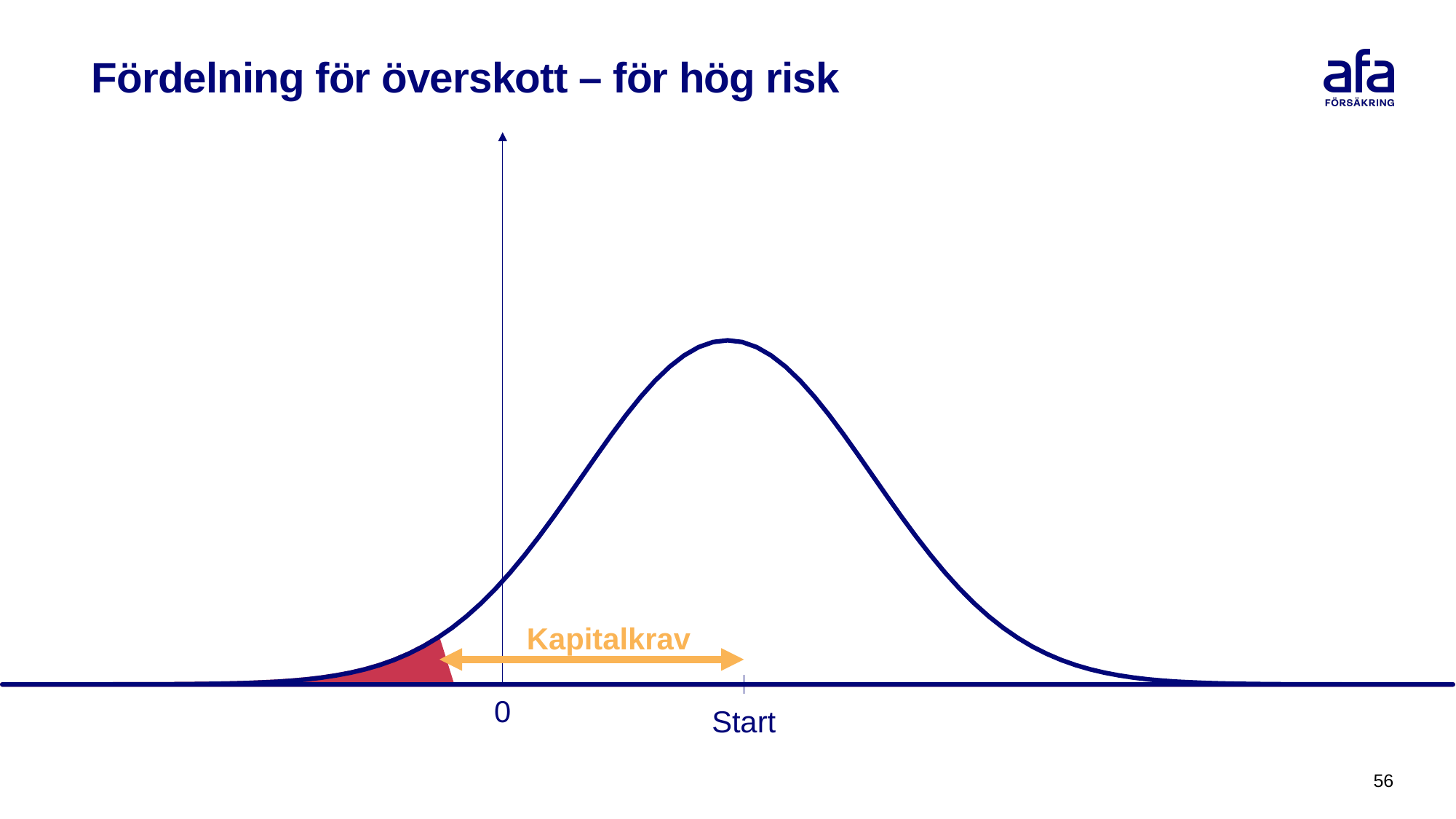
Which x-axis label is the peak of the curve located above? Start How many labels are shown on the x axis? 2 Between 0 and Start, does the curve rise or fall as you move to the right? rise To the right of Start, does the curve rise or fall as you move further right? fall What label is written on the orange double-headed arrow? Kapitalkrav What is the title of the chart on the slide? Fördelning för överskott – för hög risk Is the curve higher at 0 or at Start? Start What kind of chart is shown on the slide? a line chart